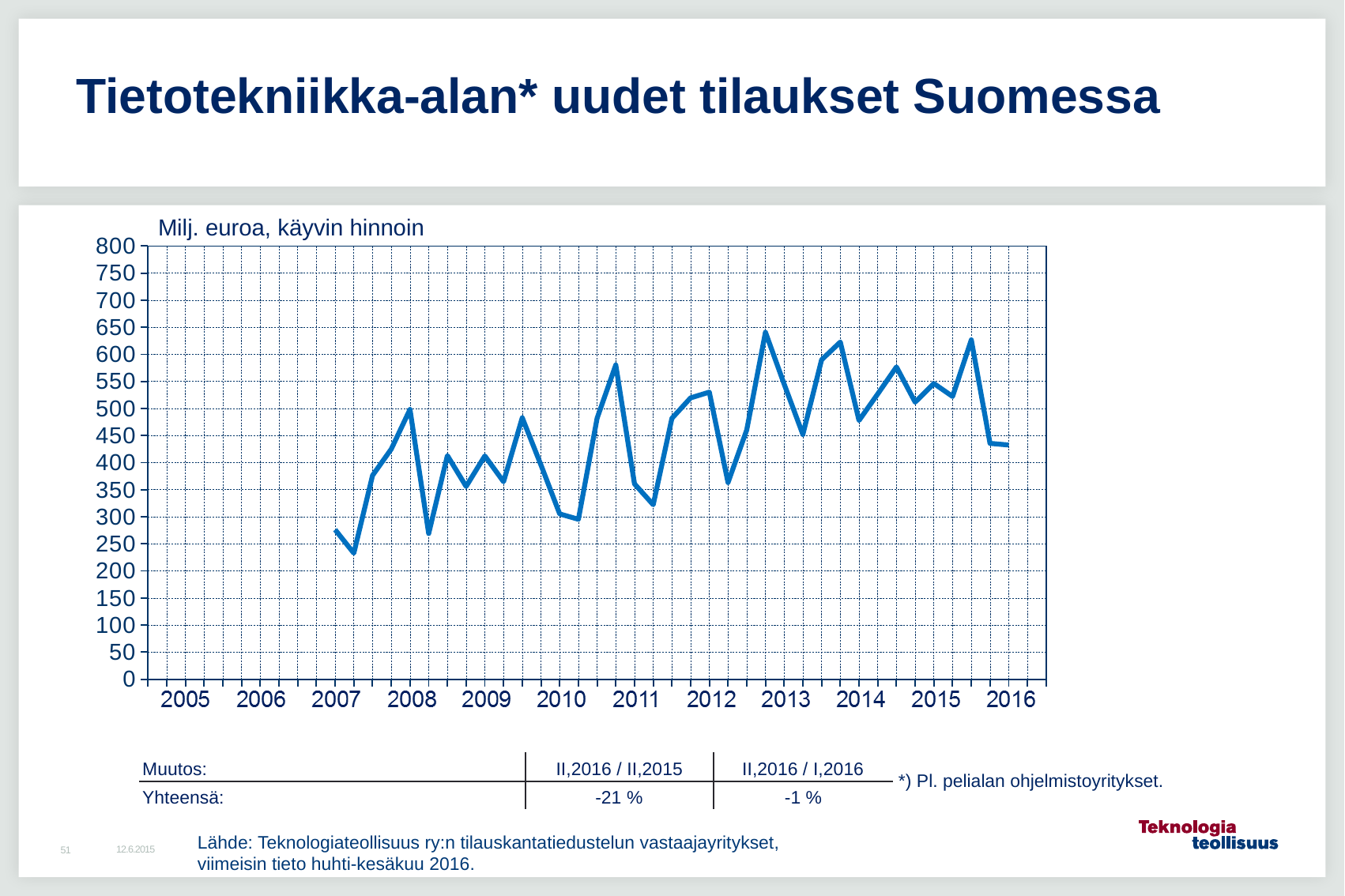
Is the last plotted value in 2016 greater or less than 500? less Does the line rise or fall between its 2015 peak and the final 2016 value? fall What kind of chart is shown on the slide? line chart What unit label is shown above the y axis of the chart? Milj. euroa, käyvin hinnoin According to the table below the chart, what is the change (Muutos) for Yhteensä in II,2016 / II,2015? -21 % Is the first plotted value in 2007 greater or less than 300? less What is the title of the slide's chart? Tietotekniikka-alan* uudet tilaukset Suomessa What is the highest value shown on the y axis of the chart? 800 How many lines are plotted on the chart? 1 In which year does the plotted line begin? 2007 How many year labels are shown on the x axis of the chart? 12